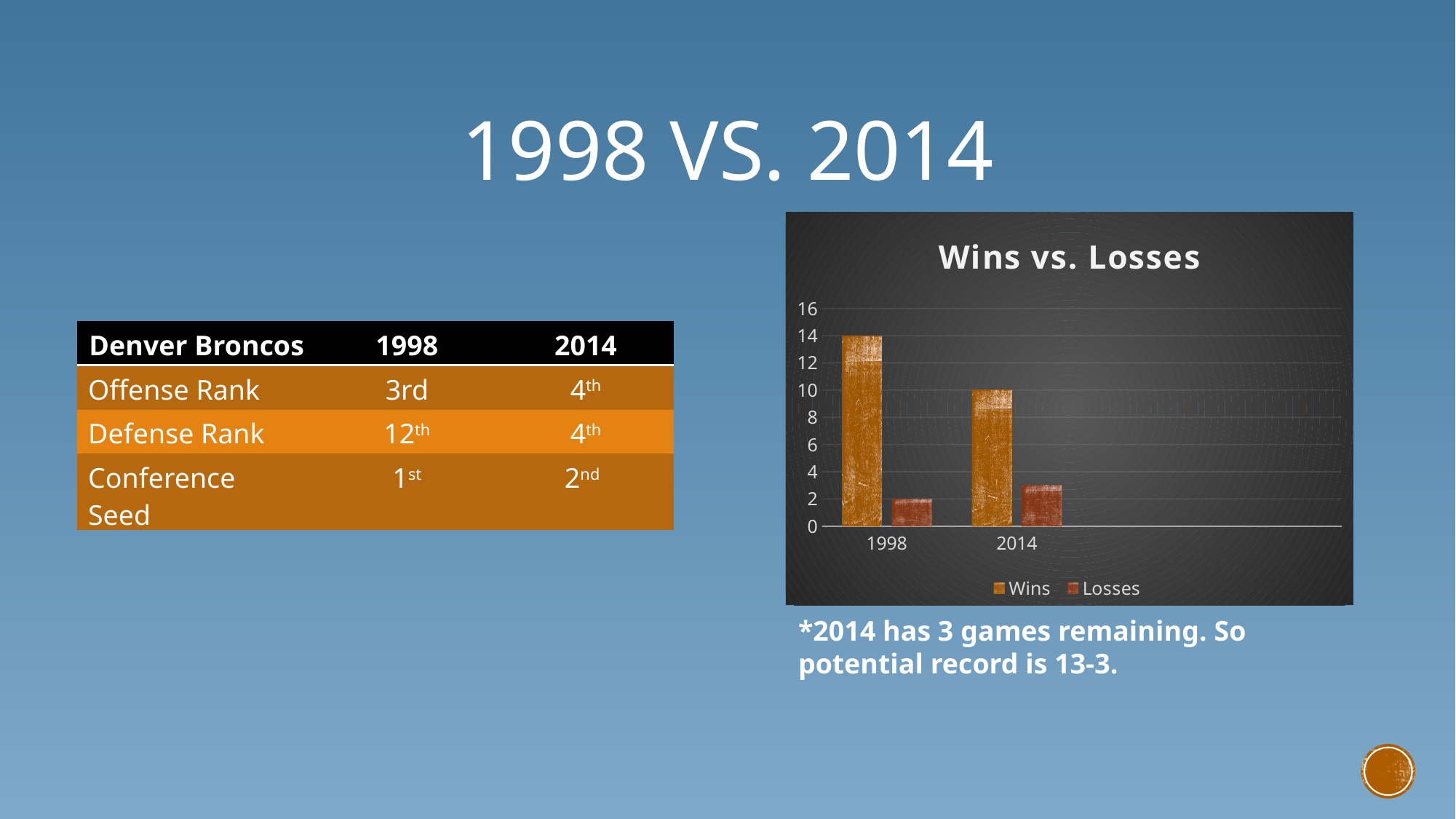
In the "Wins vs. Losses" chart, which year has the higher Wins value, 1998 or 2014? 1998 In the "Wins vs. Losses" chart, what is the value of Wins for 2014? 10 How many series does the legend of the "Wins vs. Losses" chart list? 2 In the "Wins vs. Losses" chart, is the value of Losses for 2014 greater or less than 4? less In the "Wins vs. Losses" chart, do the Wins values rise or fall from 1998 to 2014? fall What kind of chart is the "Wins vs. Losses" chart? bar chart In the "Wins vs. Losses" chart, which bar is the tallest? Wins for 1998 In the "Wins vs. Losses" chart, what is the value of Losses for 1998? 2 In the "Wins vs. Losses" chart, what is the value of Wins for 1998? 14 How many categories are shown on the x axis of the "Wins vs. Losses" chart? 2 In the "Wins vs. Losses" chart, what is the difference between Wins in 1998 and Wins in 2014? 4 What are the two legend entries of the chart on the slide? Wins and Losses